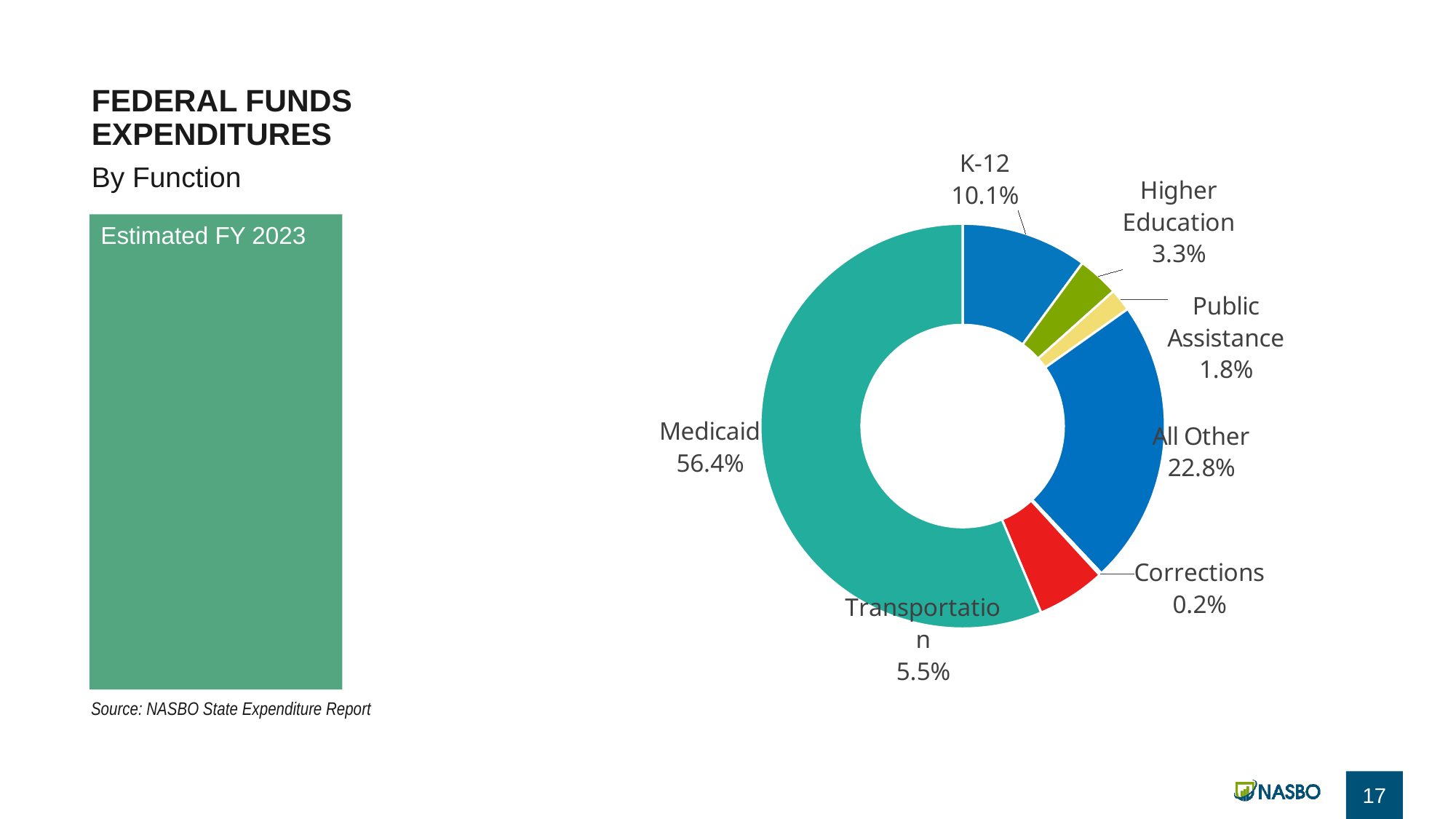
Which function has the smallest share? Corrections What kind of chart is shown on the slide? Pie chart (doughnut) How many functions are shown in the chart? 7 Which function has the largest share of federal funds expenditures? Medicaid What share of federal funds expenditures goes to Medicaid? 56.4% Which is larger, Transportation or Higher Education? Transportation What percentage is labeled for Corrections? 0.2% Which fiscal year does the chart cover? Estimated FY 2023 What is the value for Higher Education? 3.3% What is the difference in percentage points between All Other and K-12? 12.7 What percentage is shown for K-12? 10.1% What is the combined share of K-12 and Higher Education? 13.4%